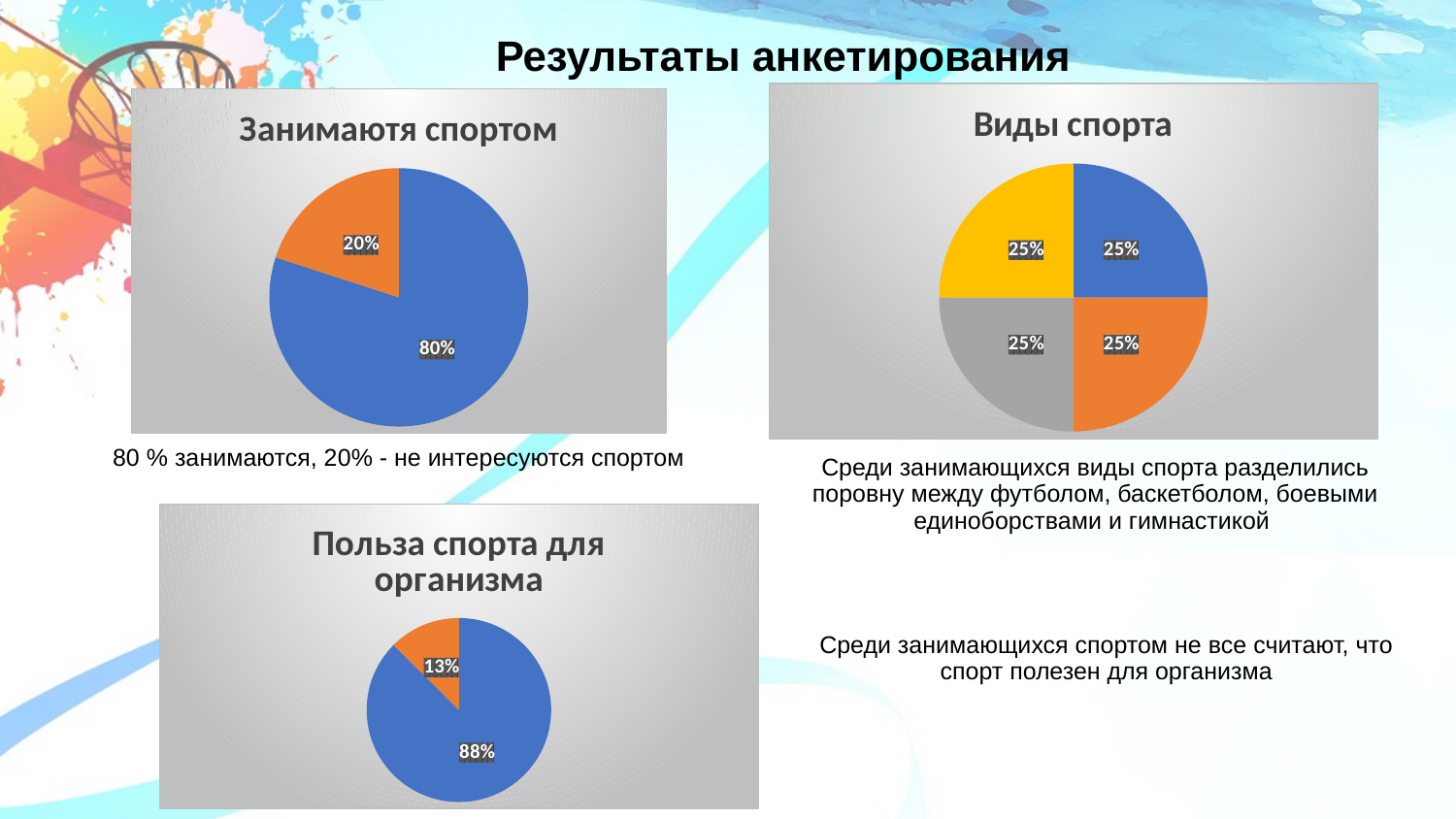
In the chart titled "Занимаютя спортом", what share does the orange slice have? 20% In the chart titled "Польза спорта для организма", what is the value of the smallest slice? 13% How many pie charts are shown on the slide? 3 In the chart titled "Польза спорта для организма", what is the value of the largest slice? 88% How many slices does the chart titled "Виды спорта" have? 4 In the chart titled "Польза спорта для организма", what is the difference between the blue slice and the orange slice? 75 percentage points How many slices does the chart titled "Польза спорта для организма" have? 2 In the chart titled "Польза спорта для организма", which slice is larger, the blue one or the orange one? The blue one In the chart titled "Виды спорта", what share does the yellow slice have? 25% In the chart titled "Занимаютя спортом", what is the difference between the two slices? 60 percentage points What type of chart is the chart titled "Занимаютя спортом"? Pie chart In the chart titled "Занимаютя спортом", what share does the blue slice have? 80%